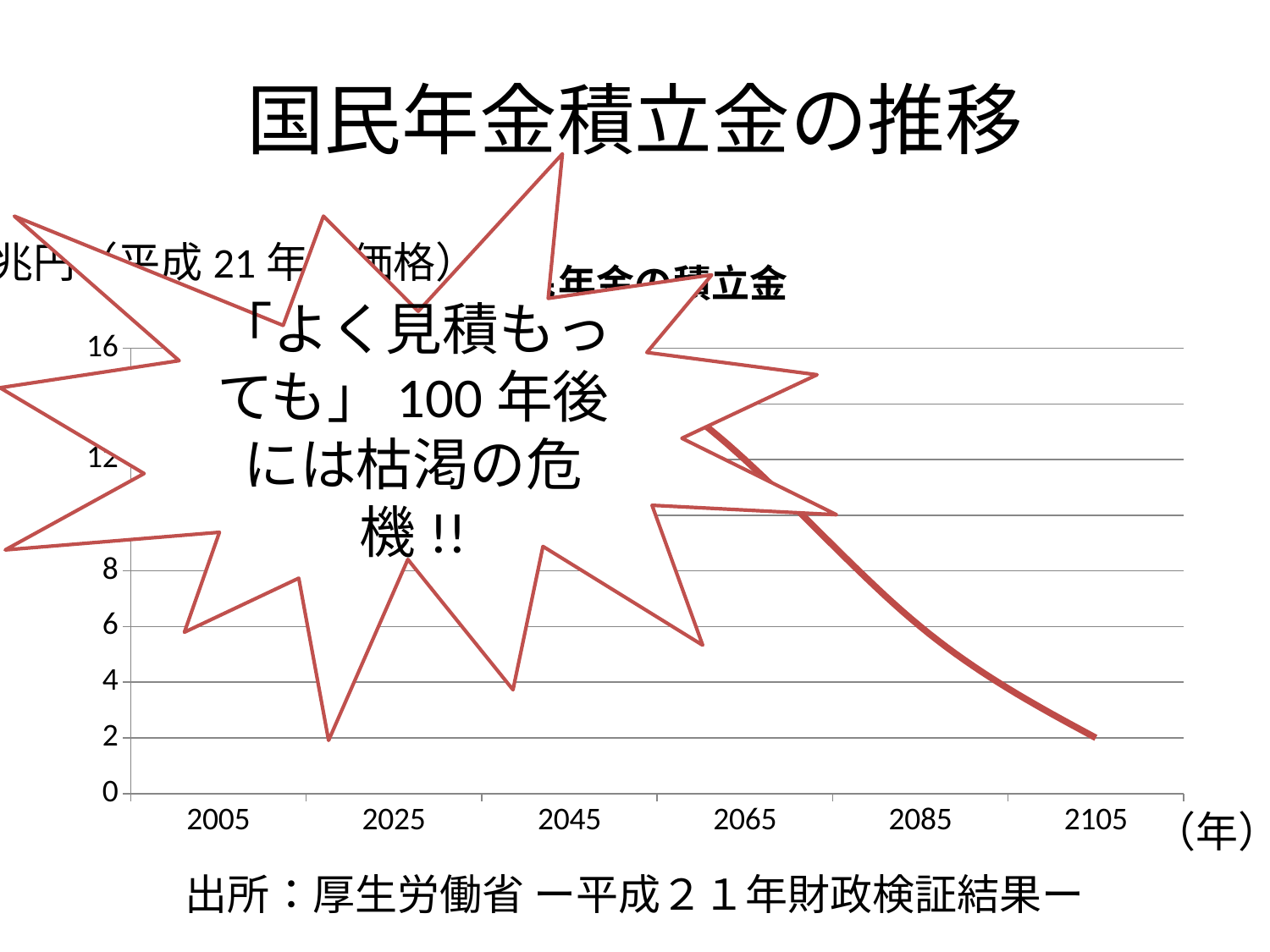
Which year has the larger value, 2085 or 2105? 2085 Between 2065 and 2105, do the plotted values rise or fall? fall What is the highest value shown on the y axis? 16 Which year has the larger value, 2065 or 2085? 2065 What kind of chart is shown on the slide? line chart Is the value for 2085 greater or less than 8? less Is the value for 2065 greater or less than 10? greater How many year labels are shown on the x axis? 6 Is the value for 2105 greater or less than 4? less What unit label is printed at the right end of the x axis? （年）